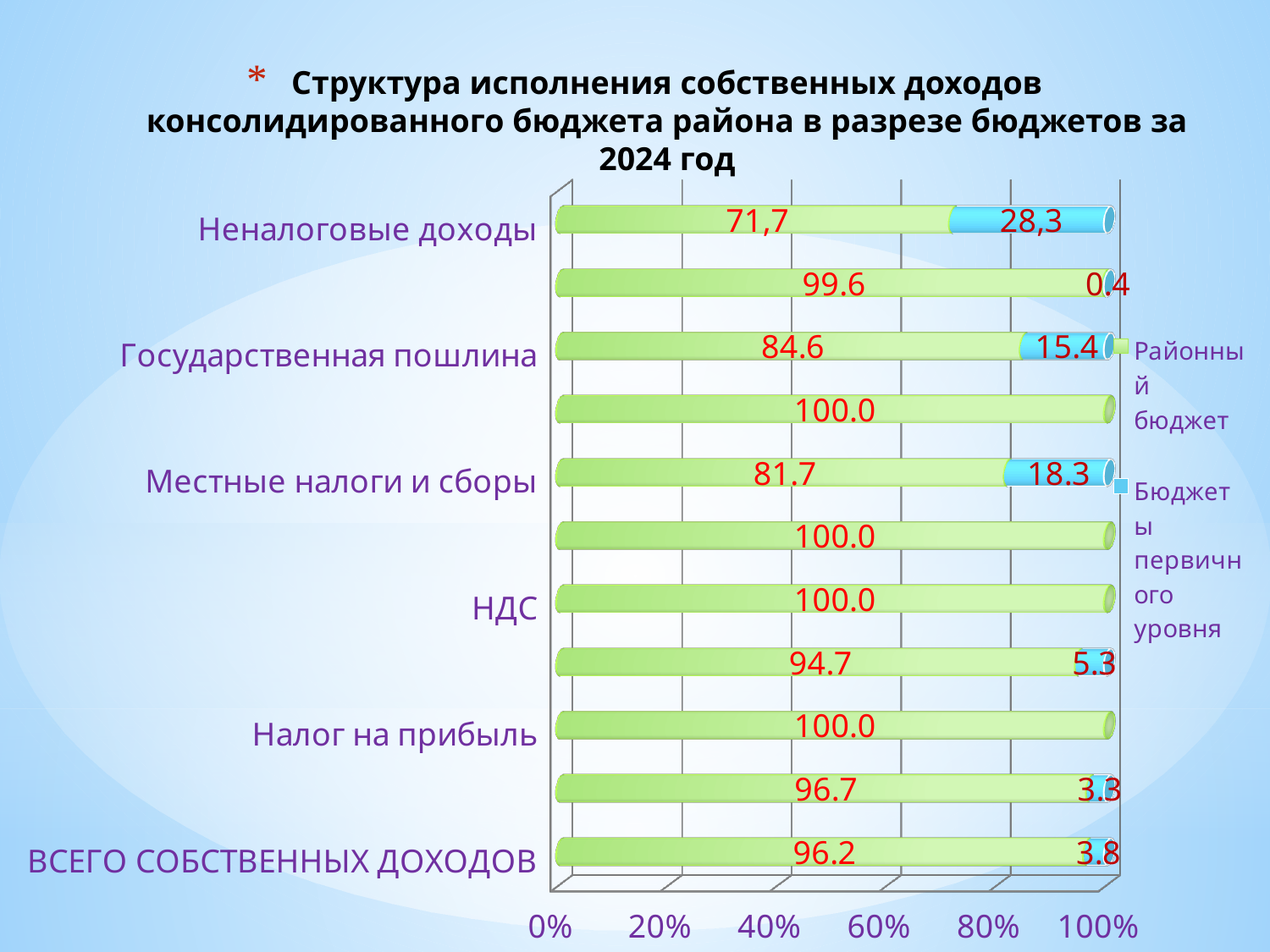
What is the value of Бюджеты первичного уровня for Местные налоги и сборы? 18.3 What is the value of Районный бюджет for Государственная пошлина? 84.6 Which colour represents Районный бюджет in the legend? green Which has a larger Районный бюджет value: Неналоговые доходы or Государственная пошлина? Государственная пошлина What is the value of Районный бюджет for НДС? 100.0 What is the value of Бюджеты первичного уровня for Неналоговые доходы? 28,3 How many series does the legend list? 2 What is the difference between the Районный бюджет and Бюджеты первичного уровня values for Государственная пошлина? 69.2 What kind of chart is shown on the slide? bar chart What is the value of Районный бюджет for Неналоговые доходы? 71,7 What is the value of Бюджеты первичного уровня for ВСЕГО СОБСТВЕННЫХ ДОХОДОВ? 3.8 What is the total of the stacked bar for Местные налоги и сборы? 100.0